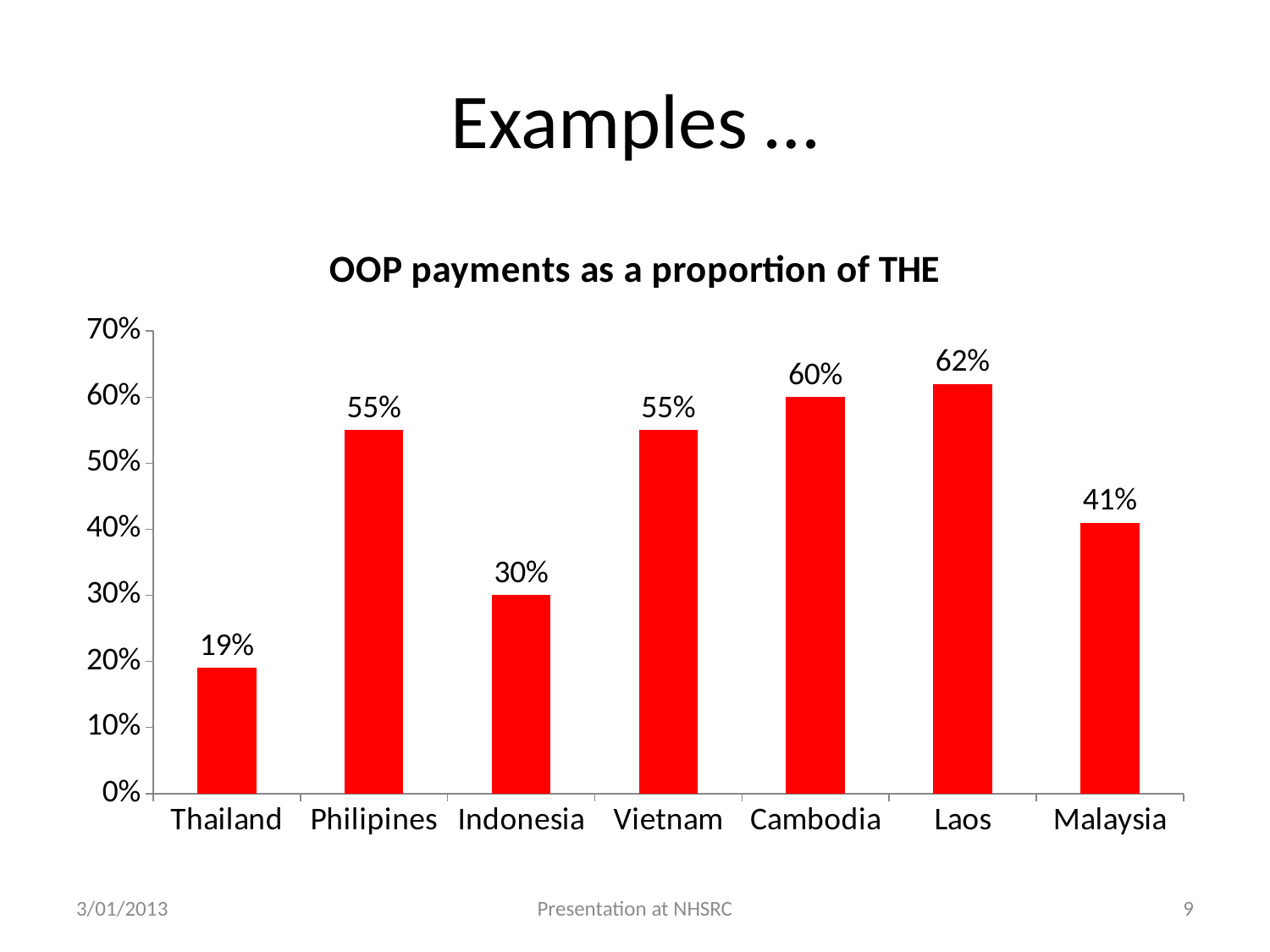
What is the value for Indonesia? 30% Which is larger, the value for Indonesia or the value for Malaysia? Malaysia Which country has the highest value? Laos Which country has the lowest value? Thailand What is the value for Malaysia? 41% What is the difference between the values for Cambodia and Malaysia? 19% What is the value for Thailand? 19% Is the value for Cambodia greater or less than 50%? greater What is the title of the chart? OOP payments as a proportion of THE What kind of chart is shown on the slide? bar chart How many countries are shown on the chart? 7 What is the difference between the values for Laos and Thailand? 43%